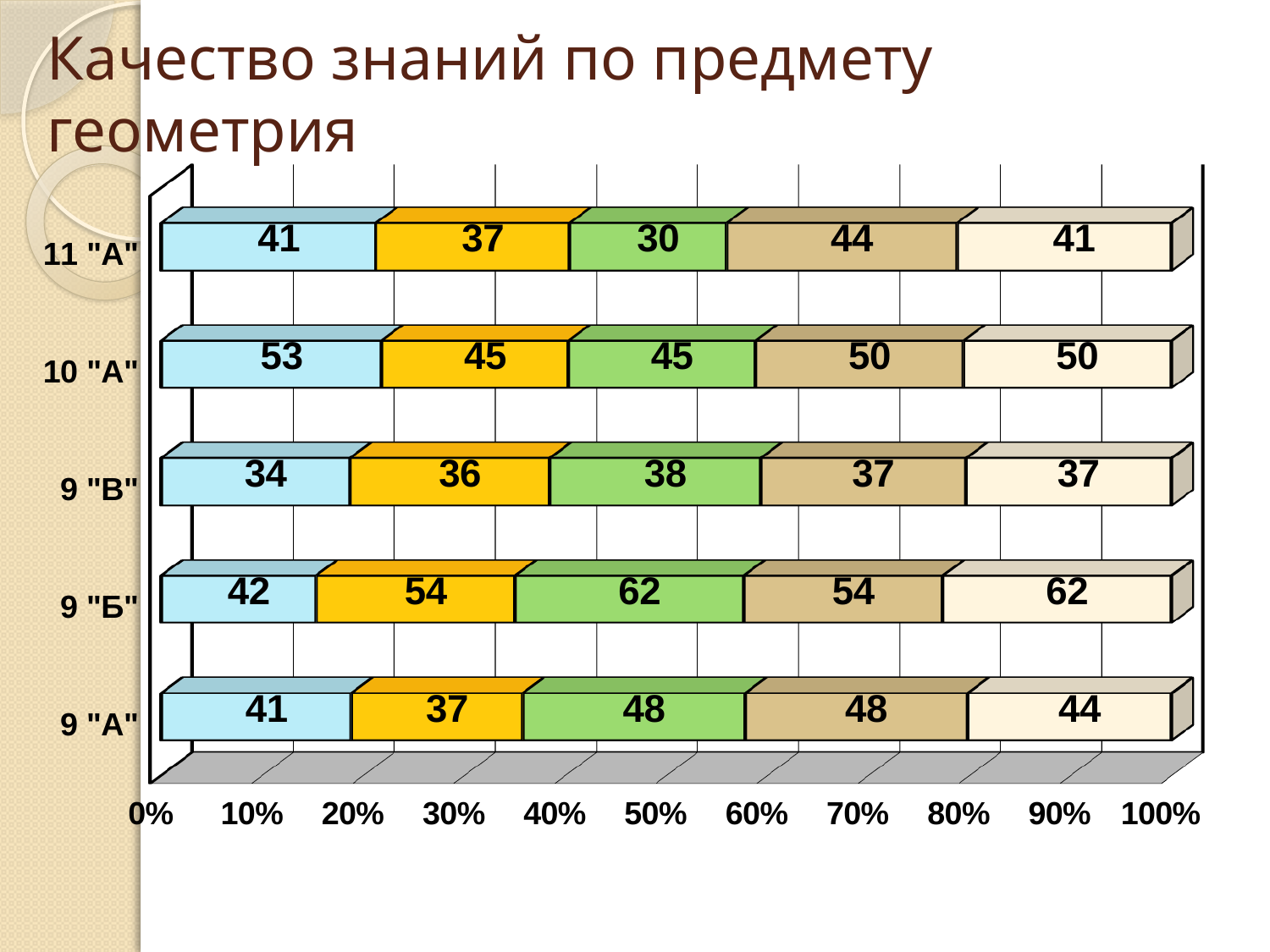
What is the value of the third (green) segment for 9 "Б"? 62 What is the value of the first (light blue) segment for 10 "А"? 53 What is the difference between the green segment (62) and the light blue segment (42) for 9 "Б"? 20 Which segment of the 10 "А" bar has the highest value? the first (light blue) segment, 53 How many segments does each bar consist of? 5 What is the value of the second (orange) segment for 9 "В"? 36 Which class has the larger value in the first (light blue) segment: 10 "А" or 9 "В"? 10 "А" What kind of chart is shown on the slide? stacked bar chart Which segment of the 11 "А" bar has the lowest value? the third (green) segment, 30 What is the value of the last (cream) segment for 9 "А"? 44 What is the title of the chart? Качество знаний по предмету геометрия How many classes (categories) are shown on the vertical axis? 5